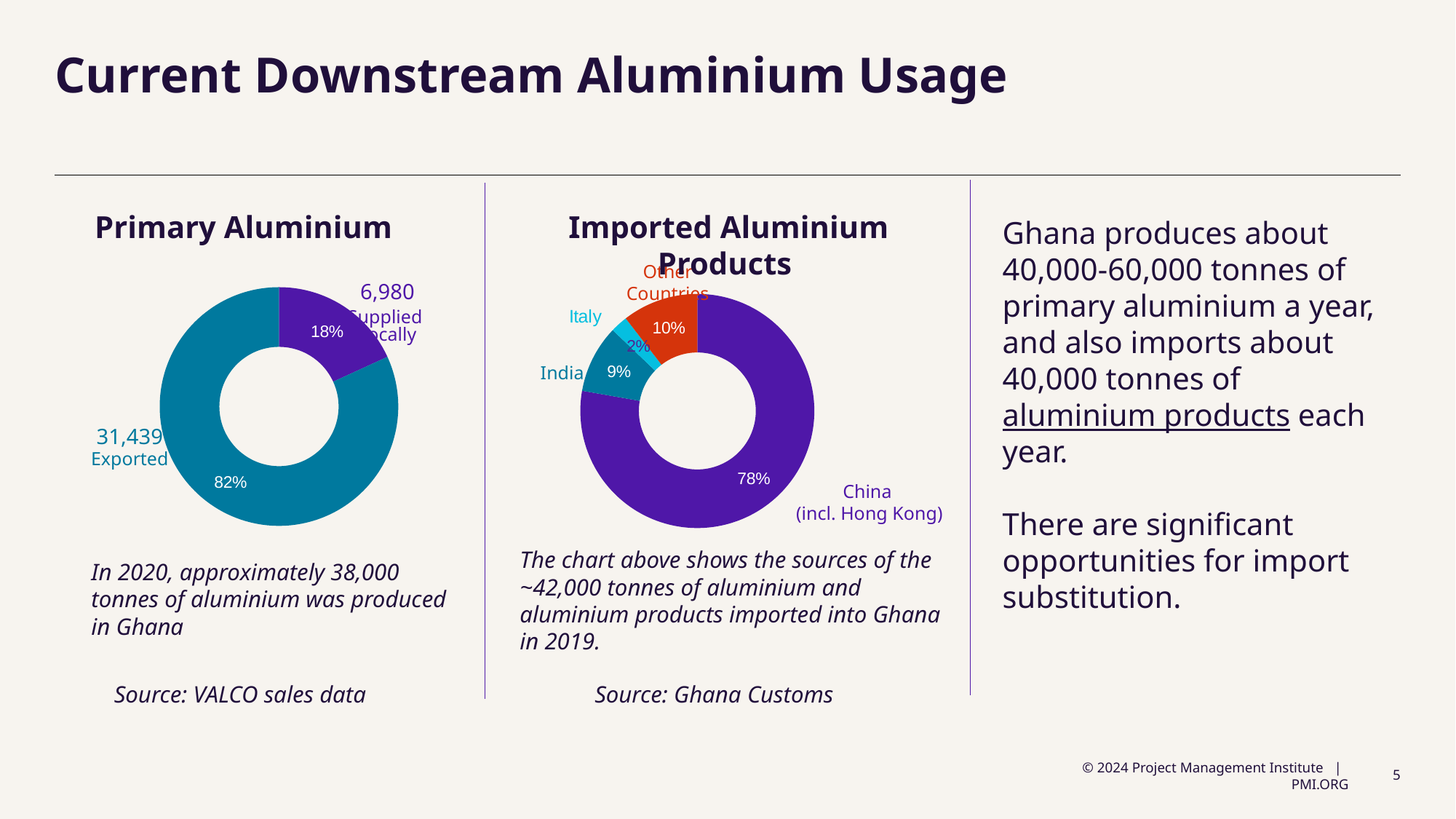
In the Primary Aluminium chart, what quantity is labelled as supplied locally? 6,980 In the Imported Aluminium Products chart, what share of imports comes from China (incl. Hong Kong)? 78% In the Primary Aluminium chart, what quantity is labelled as exported? 31,439 In the Imported Aluminium Products chart, which source has the smallest share? Italy In the Imported Aluminium Products chart, which source has the largest share? China (incl. Hong Kong) What type of chart is used for Primary Aluminium? Donut (pie) chart In the Primary Aluminium chart, what is the difference in percentage points between the exported share and the supplied locally share? 64 percentage points How many source categories are shown in the Imported Aluminium Products chart? 4 In the Imported Aluminium Products chart, what share of imports comes from India? 9% In the Primary Aluminium chart, what percentage of primary aluminium is exported? 82% In the Imported Aluminium Products chart, which is larger: the share for India or the share for Other Countries? Other Countries In the Imported Aluminium Products chart, what share of imports comes from Other Countries? 10%